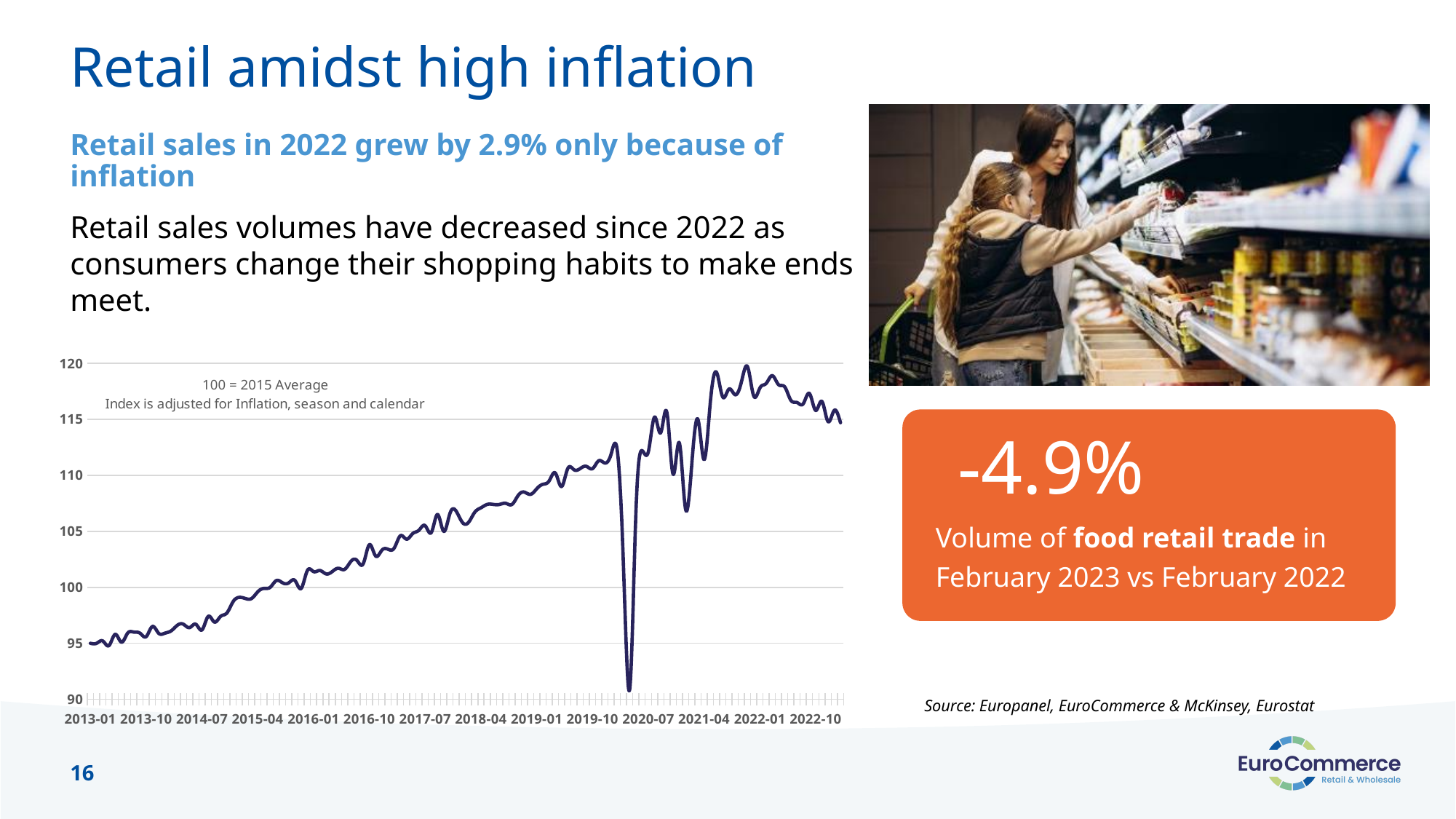
How many lines (series) are plotted on the chart? 1 What is the highest tick value shown on the y axis of the chart? 120 Is the lowest point of the line, in 2020, greater or less than 95? less Is the value of the index at 2013-01 greater or less than 100? less Is the value of the index at 2019-10 greater or less than 110? greater How many date labels are shown along the x axis of the chart? 14 According to the annotation on the chart, what does an index value of 100 represent? 2015 Average Which is larger, the index value at 2013-01 or at 2022-10? 2022-10 What kind of chart is shown on the slide? line chart Does the index generally rise or fall between 2013-01 and 2019-10? rise